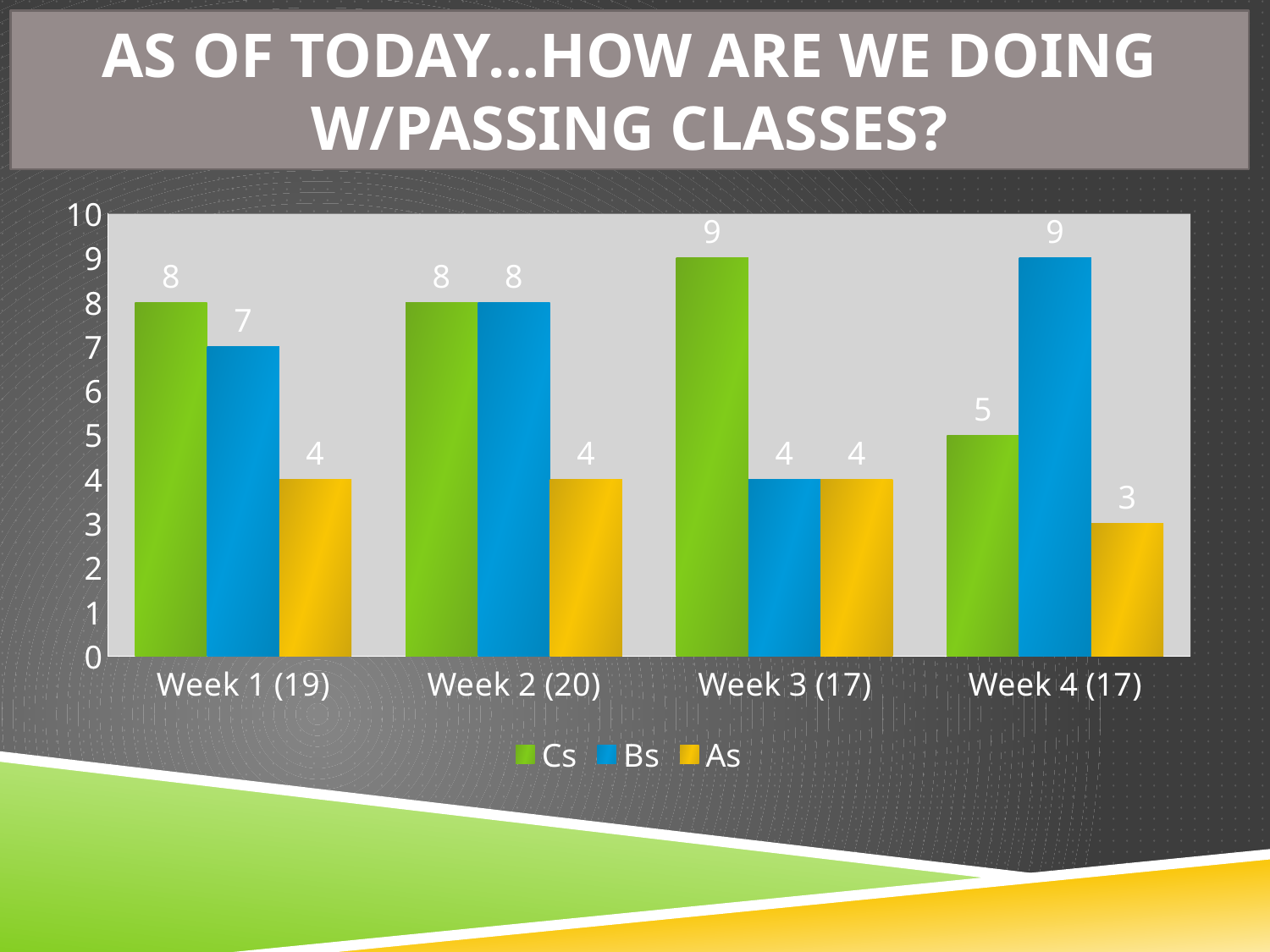
What kind of chart is shown on the slide? Bar chart What is the value for Bs in Week 1 (19)? 7 Which is larger in Week 3 (17), the Cs value or the Bs value? Cs In which week is the Bs value highest? Week 4 (17) What is the difference between the Bs value and the As value in Week 4 (17)? 6 How many week categories are shown on the x axis? 4 What is the value for As in Week 4 (17)? 3 What is the value for Cs in Week 3 (17)? 9 How many series does the legend list? 3 Which colour represents the Bs series in the legend? Blue Does the As value rise or fall from Week 3 (17) to Week 4 (17)? Fall In which week is the Cs value lowest? Week 4 (17)